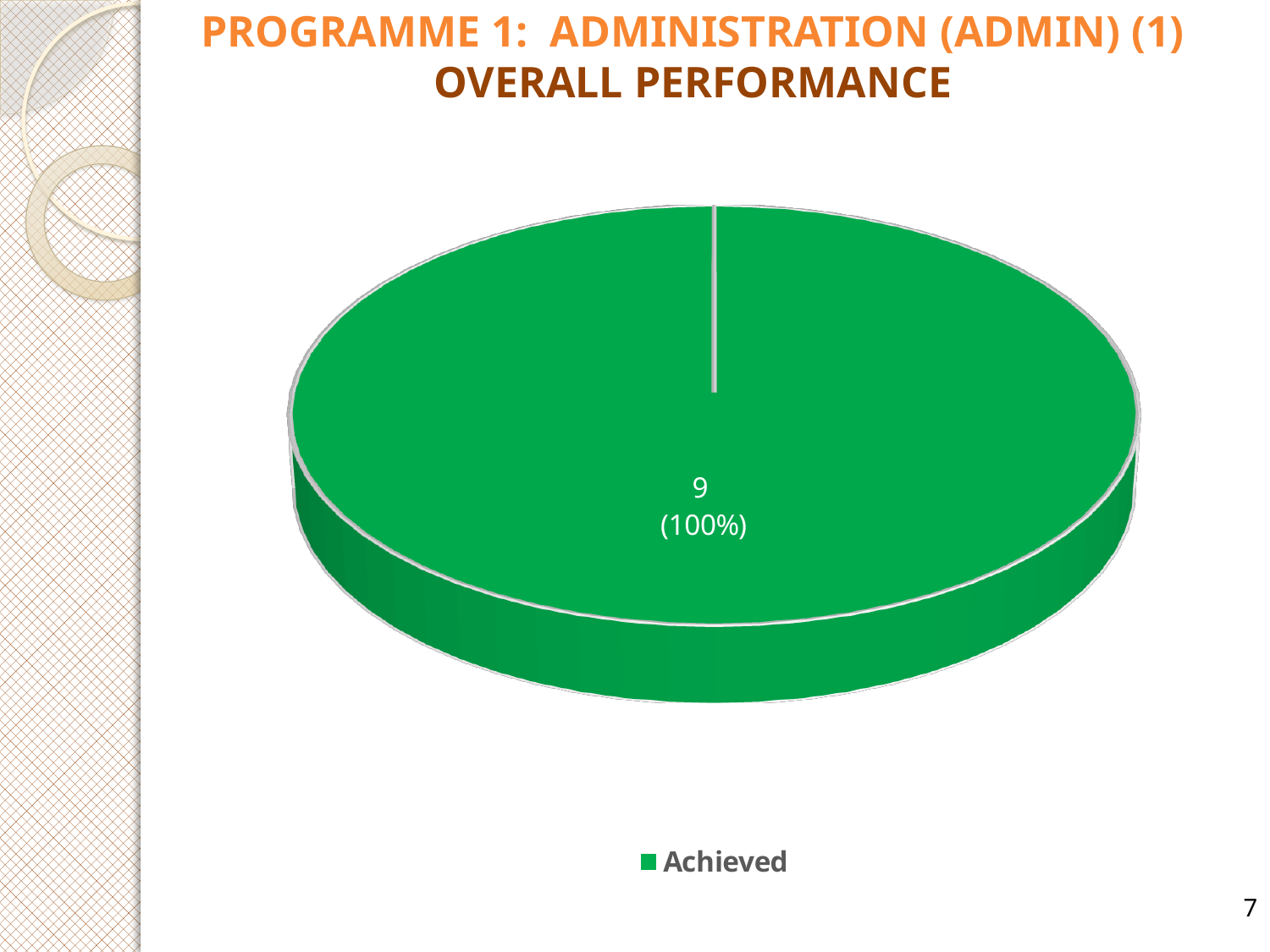
How many entries does the legend list? 1 What is the value for Achieved? 9 What is the only category shown in the legend? Achieved What kind of chart is shown on the slide? pie chart What share of the pie does the Achieved slice represent? 100% What colour is the Achieved slice? green How many slices does the pie chart have? 1 Is the value for Achieved greater or less than 5? greater